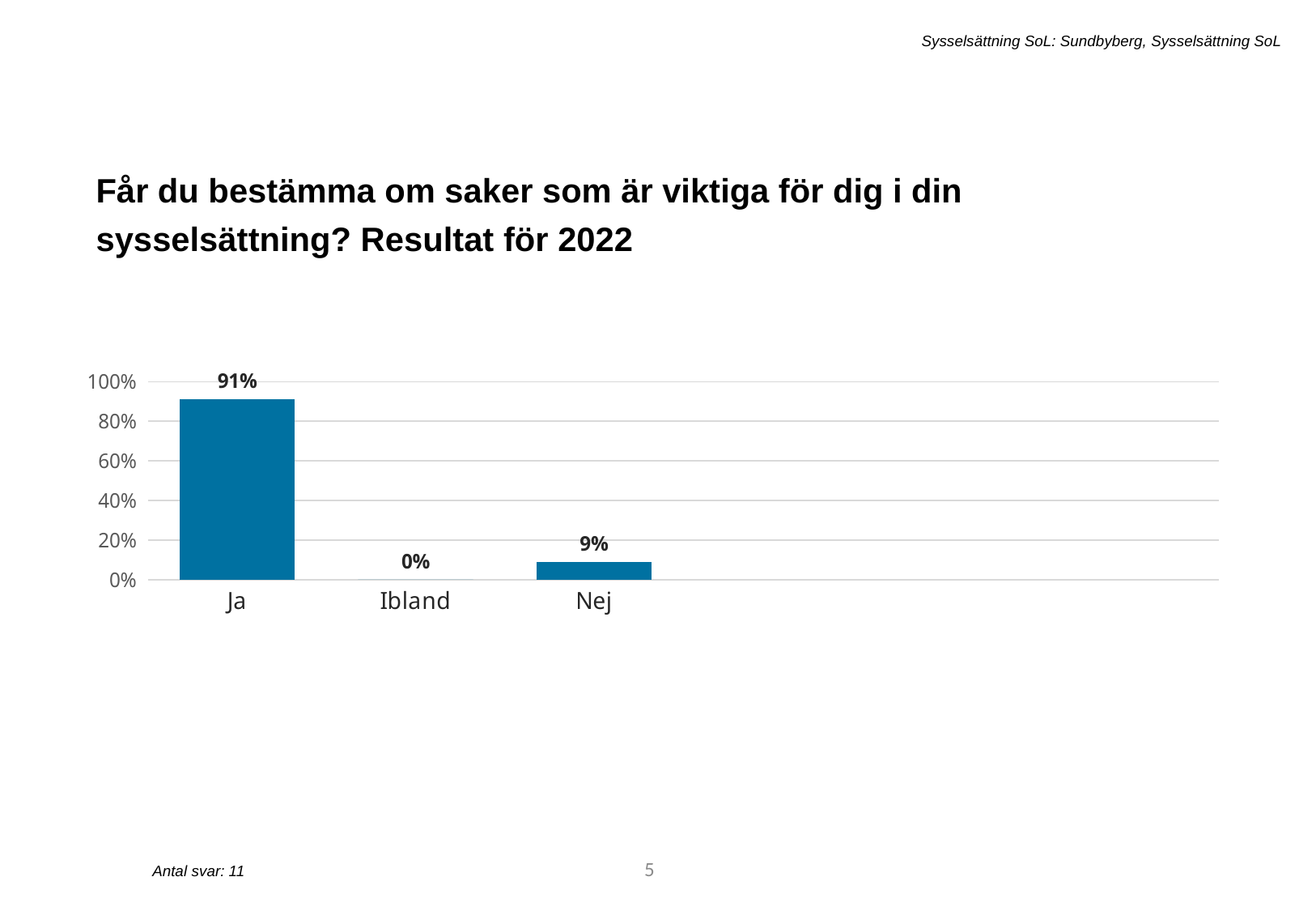
How many categories are shown on the x axis? 3 What is the value for Nej? 9% Which category has the highest value? Ja What is the value for Ja? 91% Is the value for Ja greater or less than 80%? greater What is the difference between the values for Ja and Nej? 82% What is the value for Ibland? 0% Which is larger, the value for Nej or the value for Ibland? Nej What kind of chart is shown on the slide? bar chart Which category has the lowest value? Ibland Is the value for Nej greater or less than 20%? less What is the highest value shown on the y axis? 100%